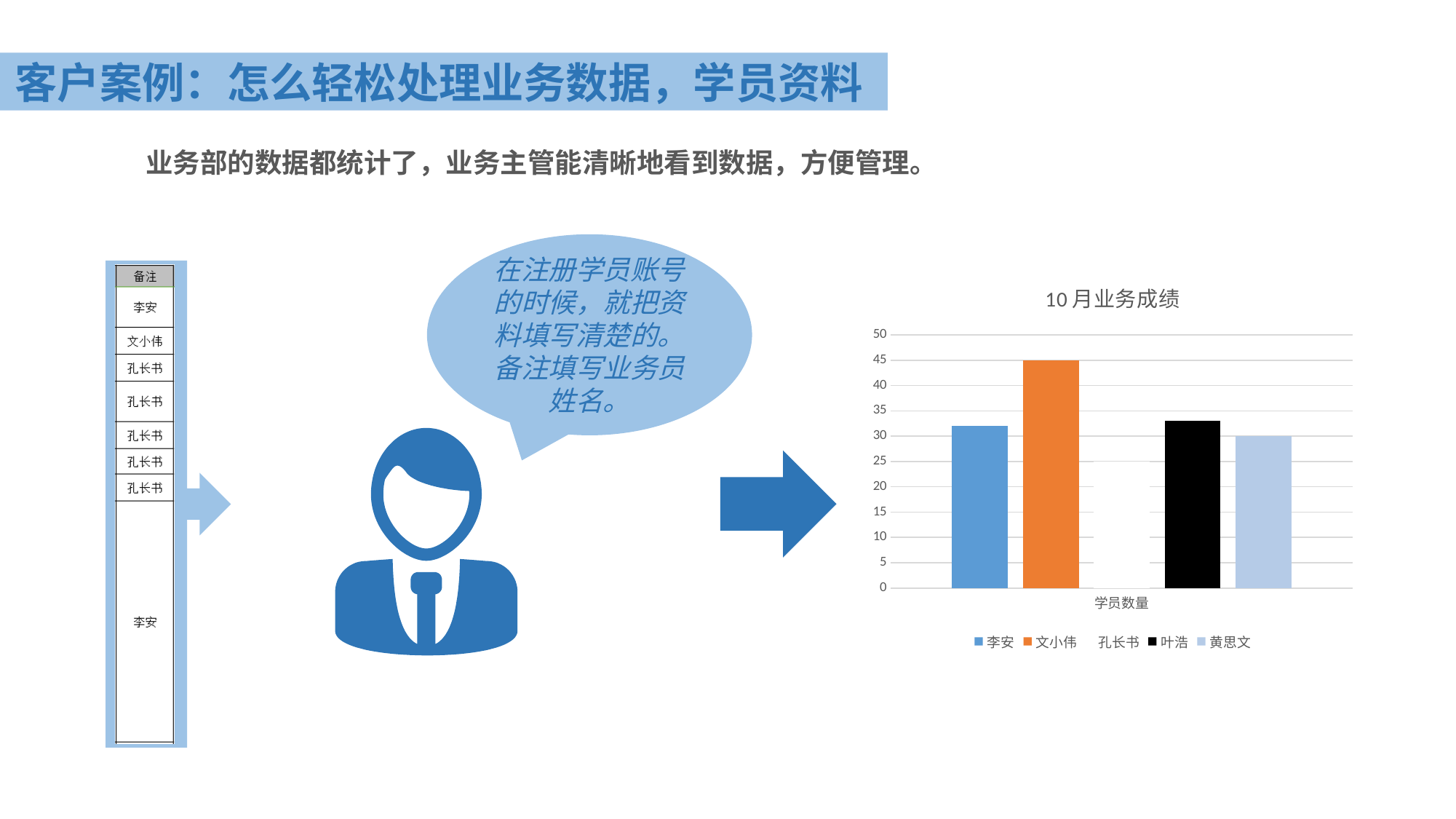
Is the value for 李安 greater or less than 35? less Is the value for 叶浩 greater or less than 30? greater How many series does the chart legend list? 5 Which is larger, the value for 叶浩 or the value for 黄思文? 叶浩 Which is larger, the value for 文小伟 or the value for 李安? 文小伟 What is the value for 黄思文 in the chart? 30 Which series has the highest value in the chart? 文小伟 What is the title of the chart? 10月业务成绩 What is the category label shown on the x axis of the chart? 学员数量 What kind of chart is shown on the slide? bar chart What is the difference between the values for 文小伟 and 黄思文? 15 What is the value for 文小伟 in the chart? 45